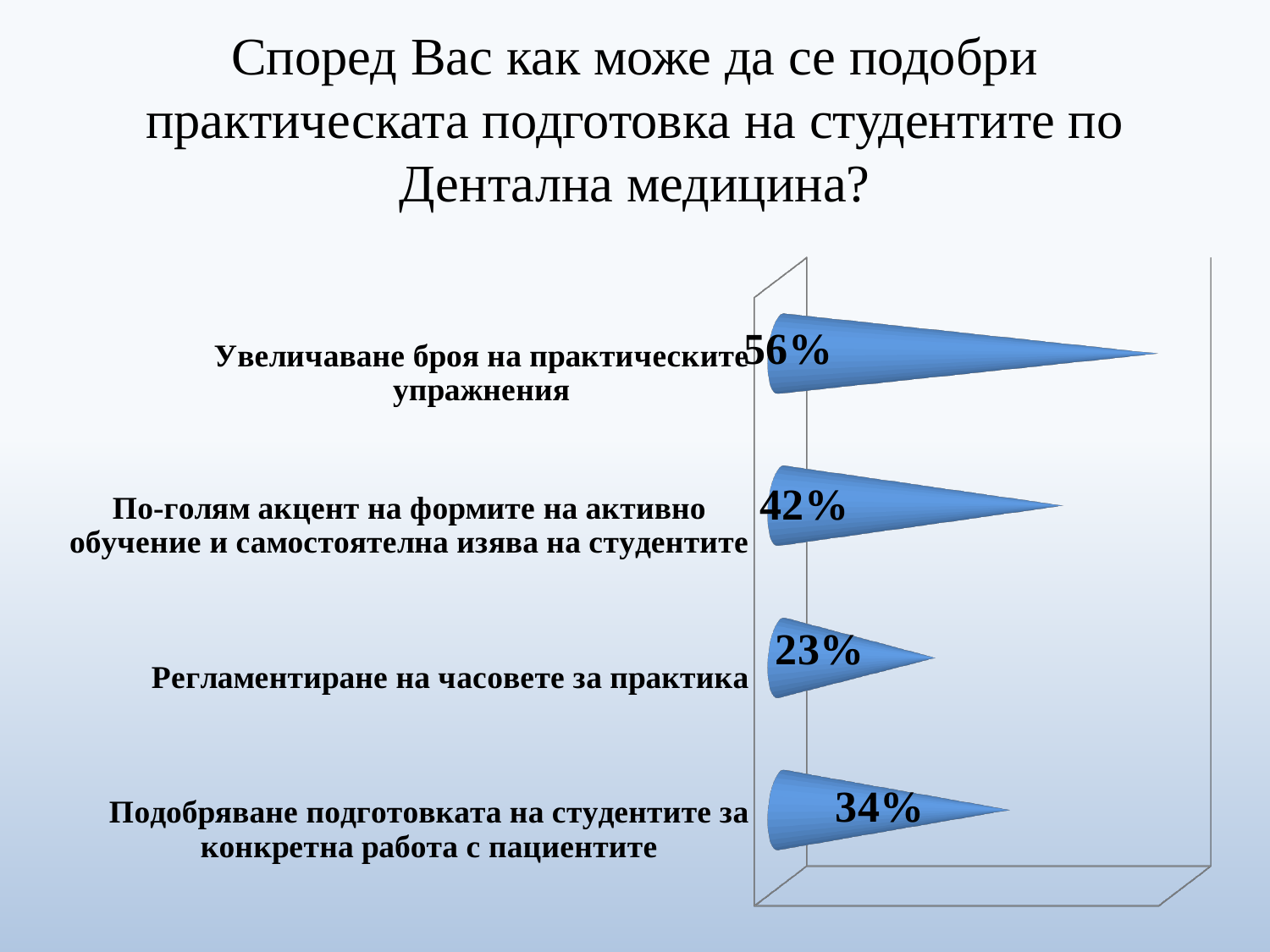
How many categories are shown in the chart? 4 What percentage is shown for "Увеличаване броя на практическите упражнения"? 56% Which is larger: the value for "Подобряване подготовката на студентите за конкретна работа с пациентите" or for "Регламентиране на часовете за практика"? Подобряване подготовката на студентите за конкретна работа с пациентите What kind of chart is shown on the slide? Bar chart What colour are the bars in the chart? Blue What is the difference between the values for "Увеличаване броя на практическите упражнения" and "Регламентиране на часовете за практика"? 33% What value is shown for "Подобряване подготовката на студентите за конкретна работа с пациентите"? 34% Which category has the highest value? Увеличаване броя на практическите упражнения What is the difference between the values for "По-голям акцент на формите на активно обучение и самостоятелна изява на студентите" and "Подобряване подготовката на студентите за конкретна работа с пациентите"? 8% Which category has the lowest value? Регламентиране на часовете за практика What value is shown for "По-голям акцент на формите на активно обучение и самостоятелна изява на студентите"? 42% What percentage is shown for "Регламентиране на часовете за практика"? 23%